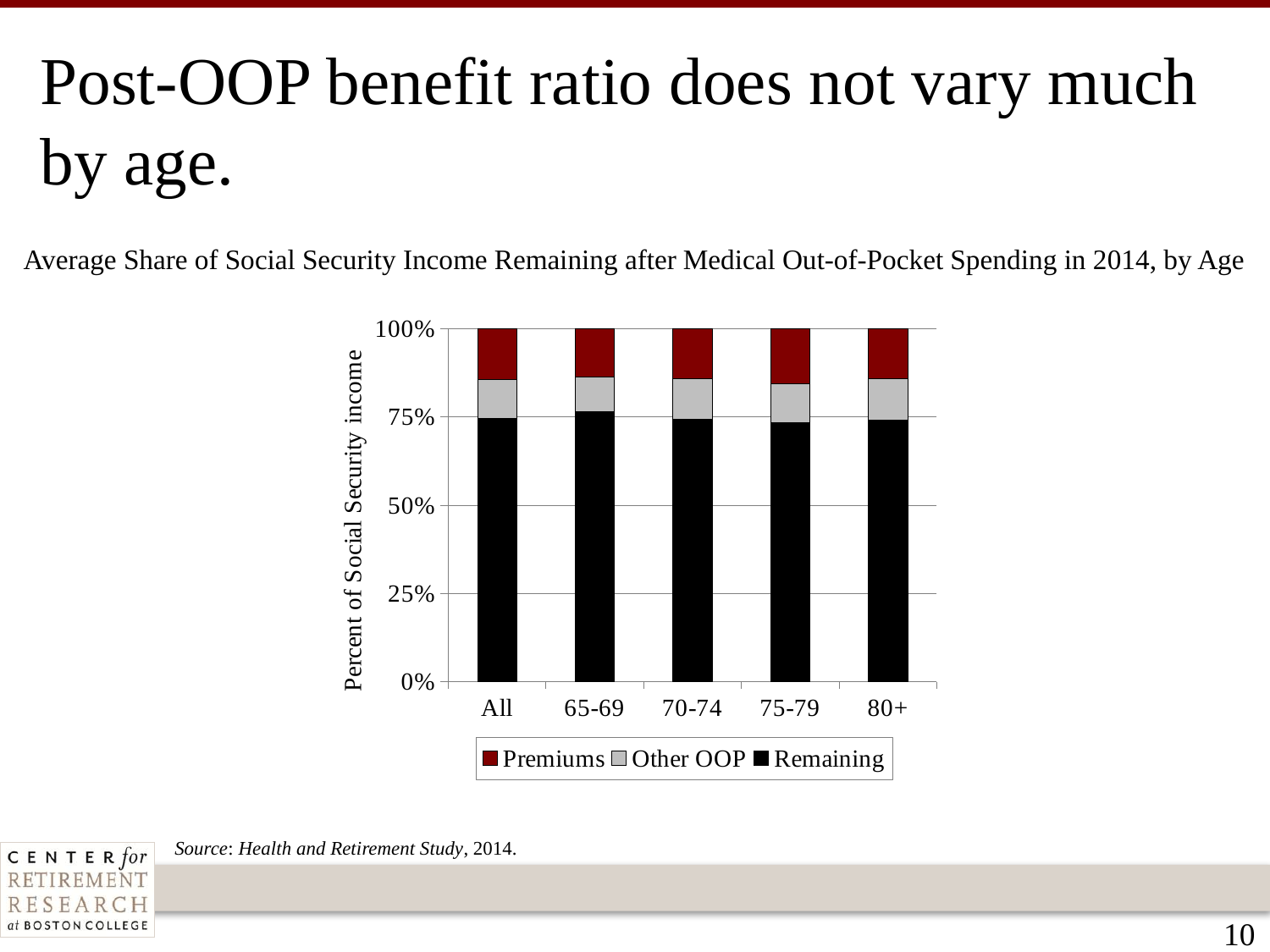
What are the three series listed in the chart's legend? Premiums, Other OOP, Remaining Which category is listed first on the x axis of the chart? All Is the 'Remaining' share for the 65-69 age group greater or less than 75%? greater Which is larger for the 'All' category: the 'Remaining' segment or the 'Premiums' segment? Remaining Which age group has the largest 'Remaining' share of Social Security income? 65-69 What kind of chart is shown on the slide? Stacked bar chart How many age categories are shown on the x axis of the chart? 5 What is the total height of the stacked bar for the 'All' category? 100% How many series does the chart's legend list? 3 Is the 'Remaining' share for the 65-69 age group greater or less than 50%? greater What is the label on the chart's vertical axis? Percent of Social Security income Is the 'Remaining' share for the 80+ age group greater or less than 50%? greater